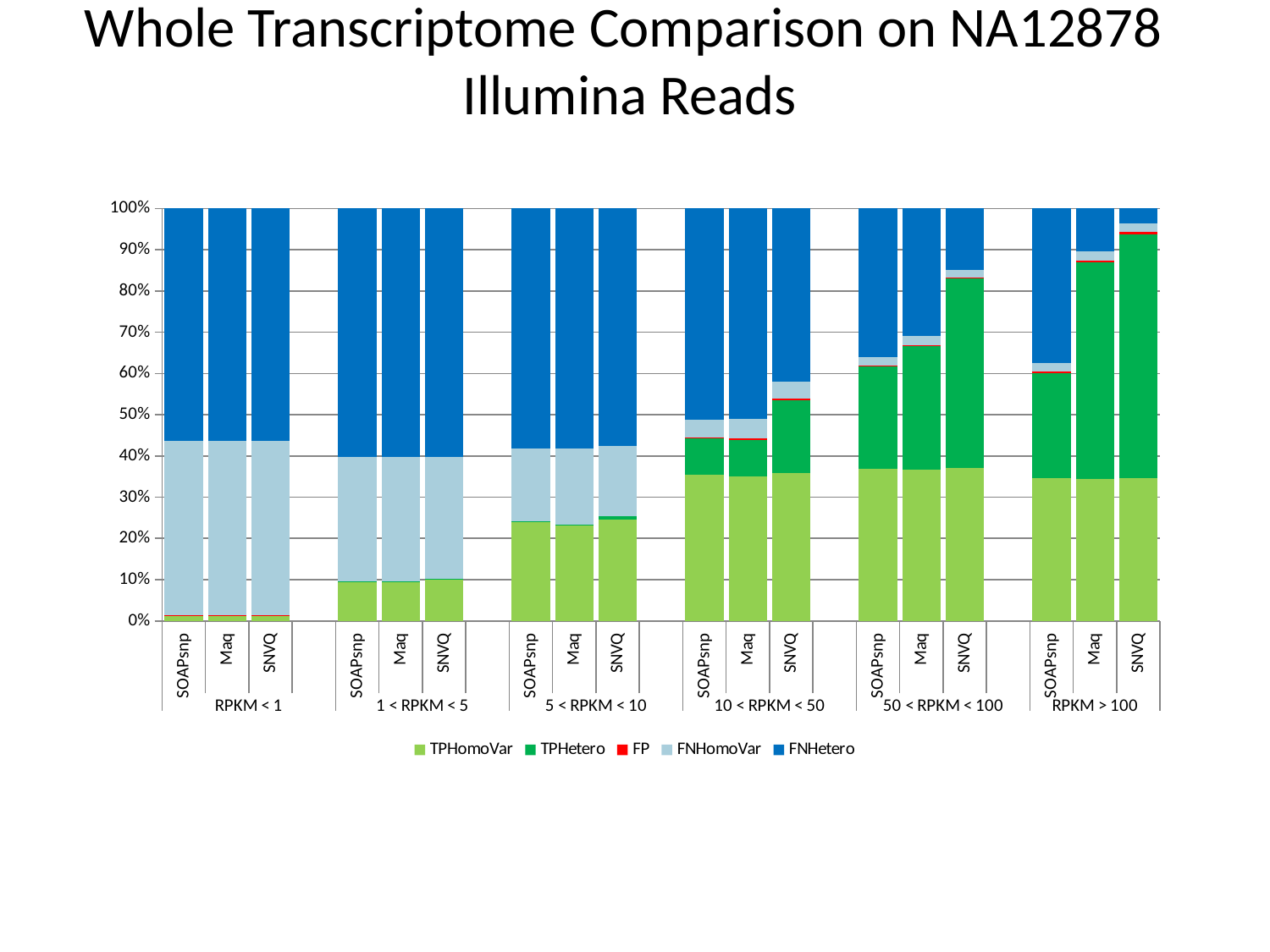
Is the TPHomoVar value for SOAPsnp in the RPKM < 1 group greater or less than 10%? less How many bars are plotted in total across all RPKM groups? 18 In the 50 < RPKM < 100 group, which tool has the largest TPHetero segment? SNVQ What kind of chart is shown on the slide? Stacked bar chart In the RPKM > 100 group, which tool has the larger TPHetero segment, SOAPsnp or SNVQ? SNVQ How many RPKM groups are shown along the x axis? 6 For SNVQ, does the TPHetero share rise or fall as the RPKM groups increase from left to right? rise For SNVQ, which RPKM group has the smallest FNHetero segment? RPKM > 100 Is the FNHetero value for SOAPsnp in the RPKM < 1 group greater or less than 50%? greater How many series does the legend list? 5 Is the TPHomoVar value for SNVQ in the RPKM > 100 group greater or less than 30%? greater What colour represents the FP series in the legend? Red